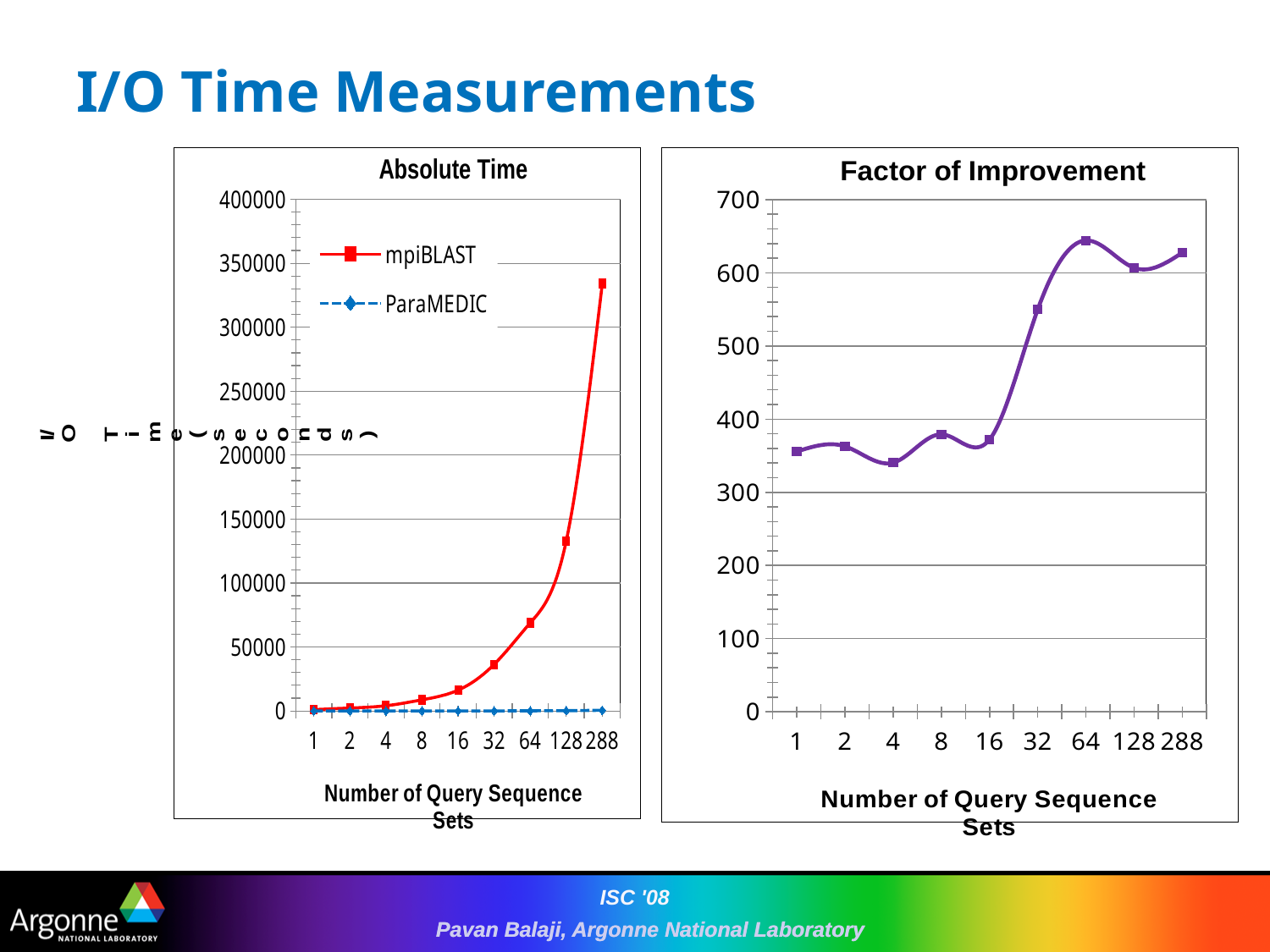
What kind of chart is the "Absolute Time" chart? line chart In the "Absolute Time" chart, is the mpiBLAST value at 128 query sequence sets greater or less than 100000? greater In the "Factor of Improvement" chart, is the value at 1 query sequence set greater or less than 400? less In the "Absolute Time" chart, how many x-axis categories are plotted? 9 In the "Absolute Time" chart, at which number of query sequence sets is the mpiBLAST time highest? 288 How many series does the legend of the "Absolute Time" chart list? 2 In the "Absolute Time" chart, does the mpiBLAST series rise or fall as the number of query sequence sets increases? rise In the "Absolute Time" chart, is the mpiBLAST value at 288 query sequence sets greater or less than 300000? greater In the "Factor of Improvement" chart, which has the larger value, 16 or 32 query sequence sets? 32 In the "Absolute Time" chart, which two series are listed in the legend? mpiBLAST and ParaMEDIC In the "Absolute Time" chart, which series has the larger value at 288 query sequence sets, mpiBLAST or ParaMEDIC? mpiBLAST